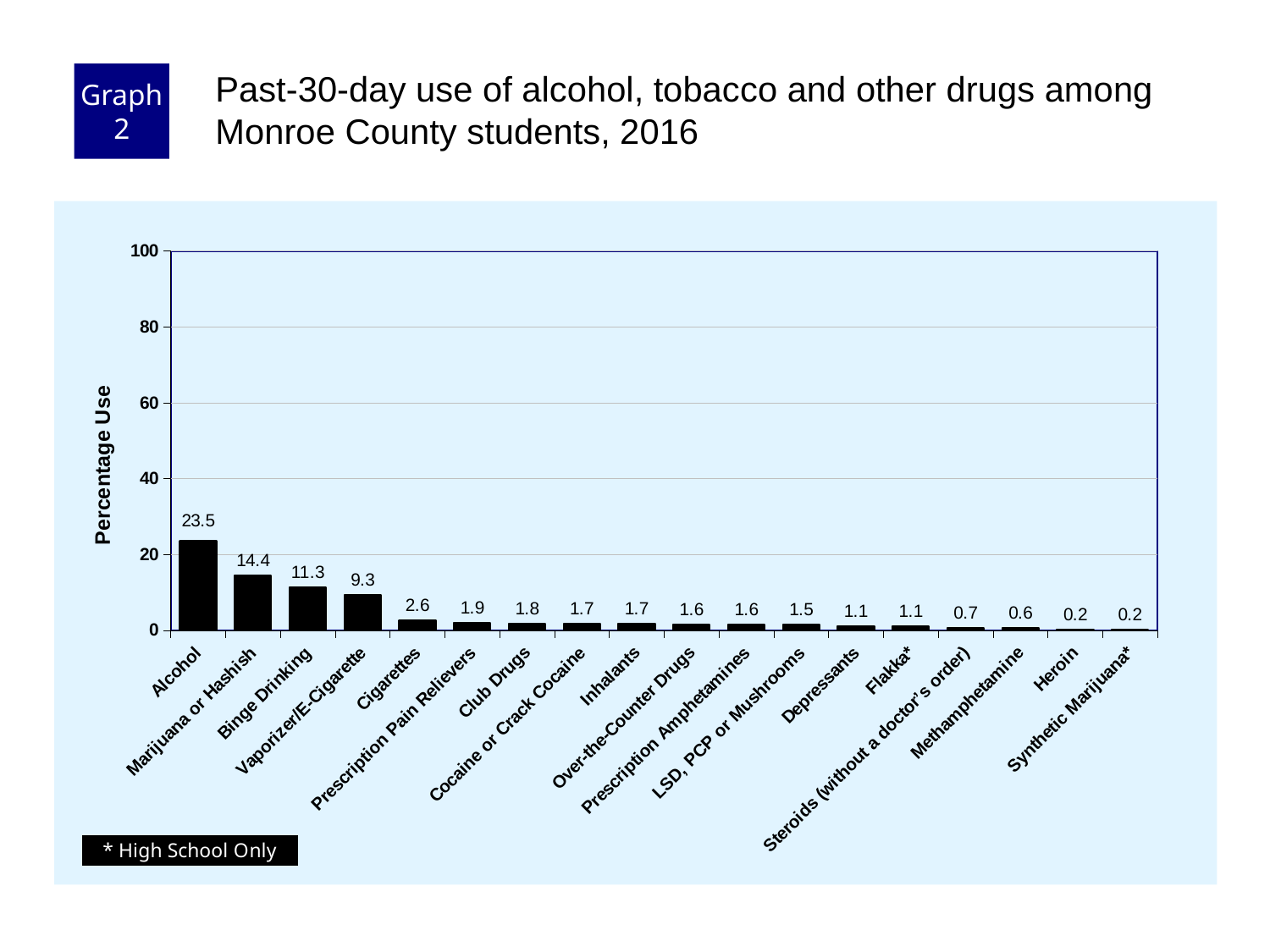
Which is larger, the value for Binge Drinking or the value for Cigarettes? Binge Drinking What kind of chart is shown on the slide? Bar chart What is the difference between the values for Binge Drinking and Vaporizer/E-Cigarette? 2.0 What is the difference between the values for Alcohol and Marijuana or Hashish? 9.1 What is the value shown for Vaporizer/E-Cigarette? 9.3 Which category has the highest past-30-day use? Alcohol What is the value shown for Methamphetamine? 0.6 Is the value for Alcohol greater or less than 20? greater What is the past-30-day use percentage for Alcohol? 23.5 How many categories are shown on the x axis? 18 What is the label of the y axis? Percentage Use What is the value shown for Cigarettes? 2.6